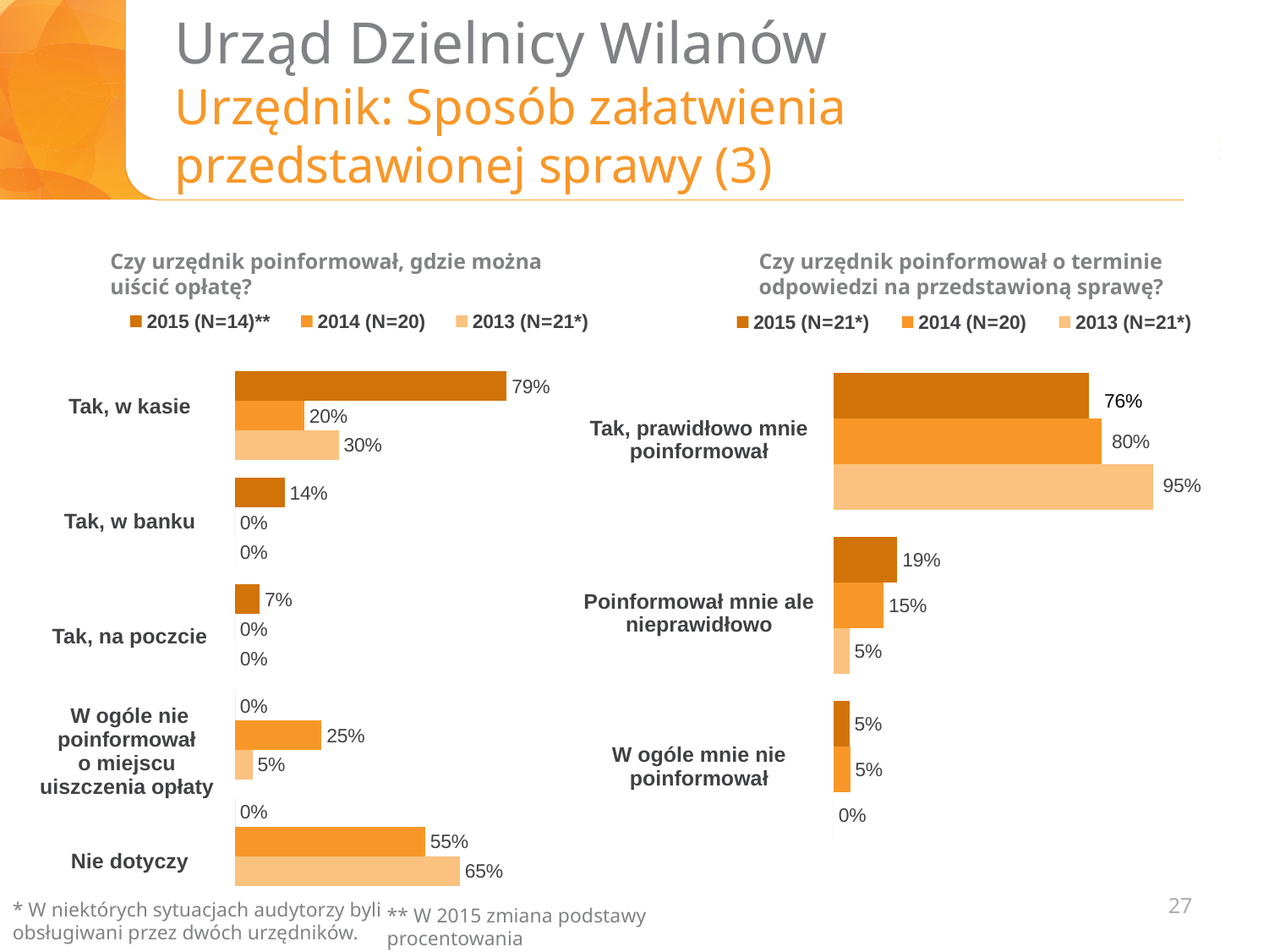
In the right chart ("Czy urzędnik poinformował o terminie odpowiedzi na przedstawioną sprawę?"), what is the difference between the 2013 and 2015 values for "Tak, prawidłowo mnie poinformował"? 19 percentage points In the right chart ("Czy urzędnik poinformował o terminie odpowiedzi na przedstawioną sprawę?"), what is the 2015 value for "Poinformował mnie ale nieprawidłowo"? 19% In the left chart ("Czy urzędnik poinformował, gdzie można uiścić opłatę?"), what is the 2014 value for "W ogóle nie poinformował o miejscu uiszczenia opłaty"? 25% What type of chart is used on the left side of the slide? Bar chart In the left chart ("Czy urzędnik poinformował, gdzie można uiścić opłatę?"), which category has the highest 2014 value? Nie dotyczy In the left chart ("Czy urzędnik poinformował, gdzie można uiścić opłatę?"), what is the difference between the 2015 and 2014 values for "Tak, w kasie"? 59 percentage points In the right chart ("Czy urzędnik poinformował o terminie odpowiedzi na przedstawioną sprawę?"), what is the 2013 value for "Tak, prawidłowo mnie poinformował"? 95% In the left chart ("Czy urzędnik poinformował, gdzie można uiścić opłatę?"), how many categories are shown? 5 In the right chart ("Czy urzędnik poinformował o terminie odpowiedzi na przedstawioną sprawę?"), which is larger for "Tak, prawidłowo mnie poinformował": the 2015 value or the 2014 value? 2014 How many series does the legend of the right chart list? 3 In the left chart ("Czy urzędnik poinformował, gdzie można uiścić opłatę?"), what is the 2015 value for "Tak, w kasie"? 79% In the left chart ("Czy urzędnik poinformował, gdzie można uiścić opłatę?"), what is the 2013 value for "Nie dotyczy"? 65%